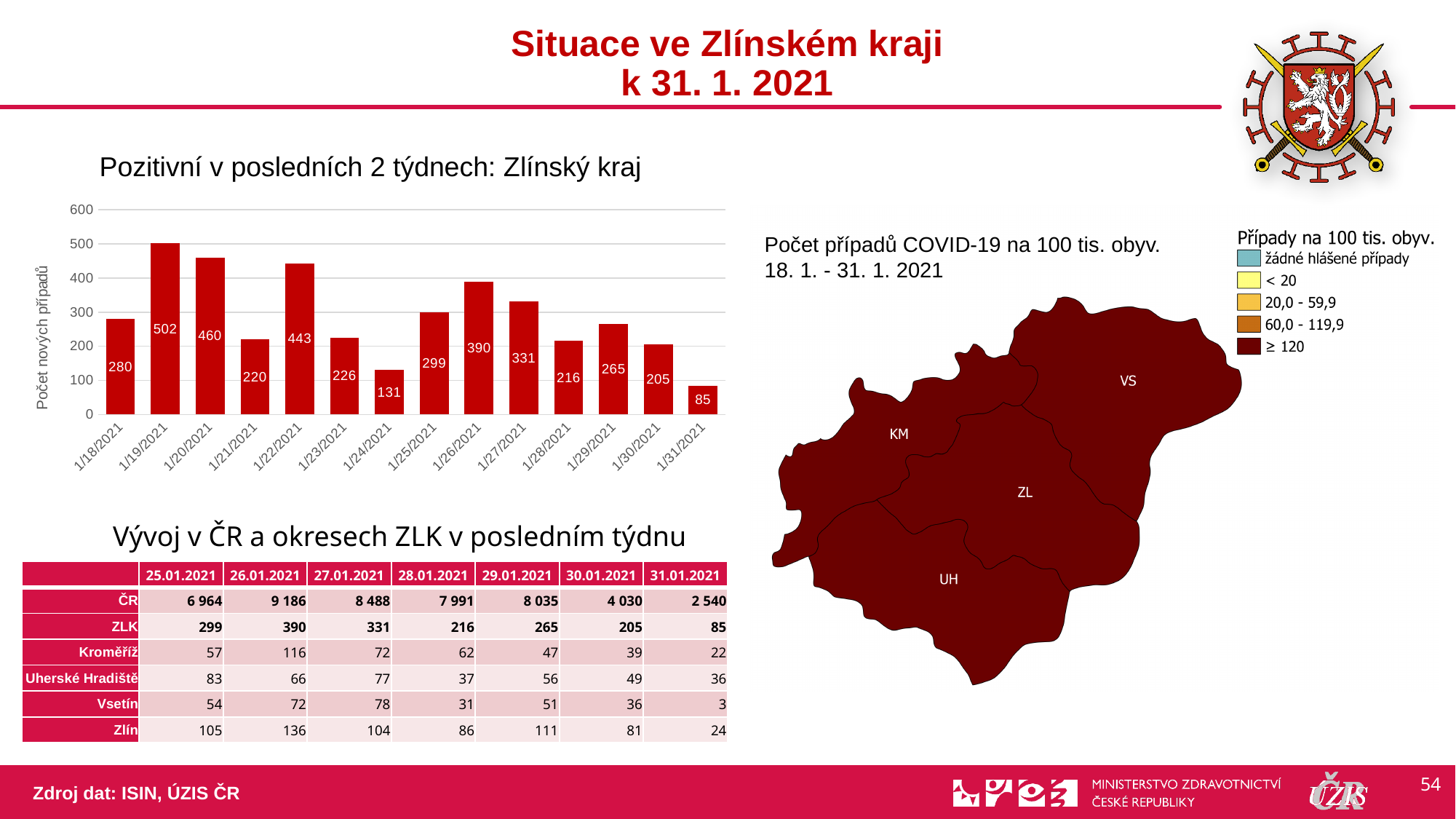
In the bar chart, what is the value for 1/19/2021? 502 In the bar chart, what is the value for 1/28/2021? 216 Which date has the lowest value in the bar chart? 1/31/2021 Which date has the highest value in the bar chart? 1/19/2021 What is the y-axis title of the bar chart? Počet nových případů In the bar chart, what is the difference between the values for 1/19/2021 and 1/31/2021? 417 In the bar chart, is the value for 1/26/2021 greater or less than 300? greater In the bar chart, which is larger: the value for 1/22/2021 or the value for 1/26/2021? 1/22/2021 What type of chart is used to show 'Pozitivní v posledních 2 týdnech: Zlínský kraj'? bar chart How many dates (bars) are shown in the bar chart? 14 In the bar chart, what is the difference between the values for 1/18/2021 and 1/21/2021? 60 In the bar chart, what is the value for 1/24/2021? 131